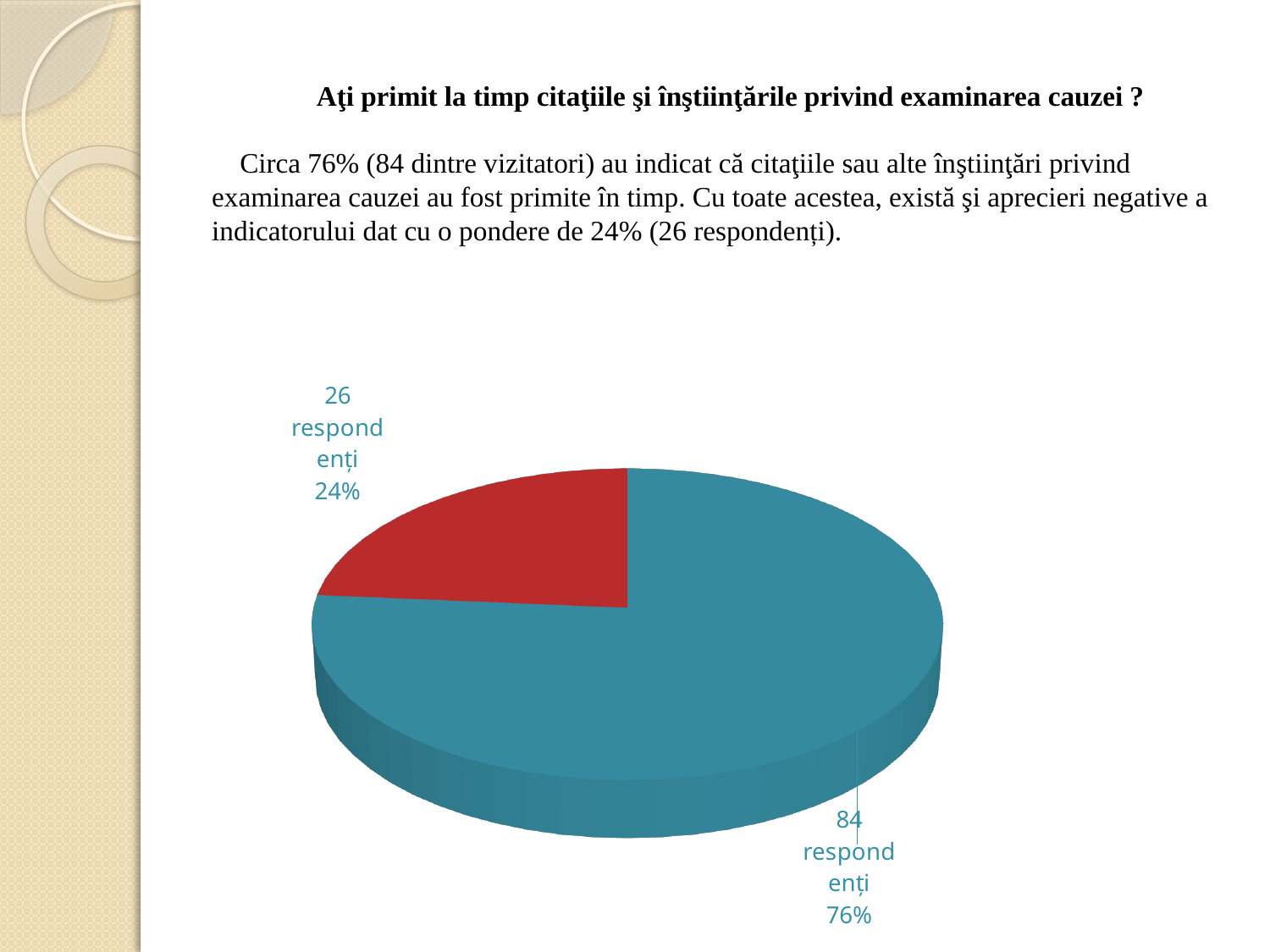
Which slice represents more respondents, the blue one or the red one? the blue one How many respondents does the blue slice of the pie chart represent? 84 respondenți Which slice of the pie chart is the largest? the blue slice (84 respondenți, 76%) How many slices does the pie chart have? 2 Which slice of the pie chart is the smallest? the red slice (26 respondenți, 24%) What percentage share does the red slice of the pie chart represent? 24% What is the total number of respondents shown across both slices of the pie chart? 110 What kind of chart is shown on the slide? pie chart What is the difference in the number of respondents between the blue slice and the red slice? 58 What percentage share does the blue slice of the pie chart represent? 76% How many respondents does the red slice of the pie chart represent? 26 respondenți What is the difference in percentage points between the blue slice and the red slice? 52